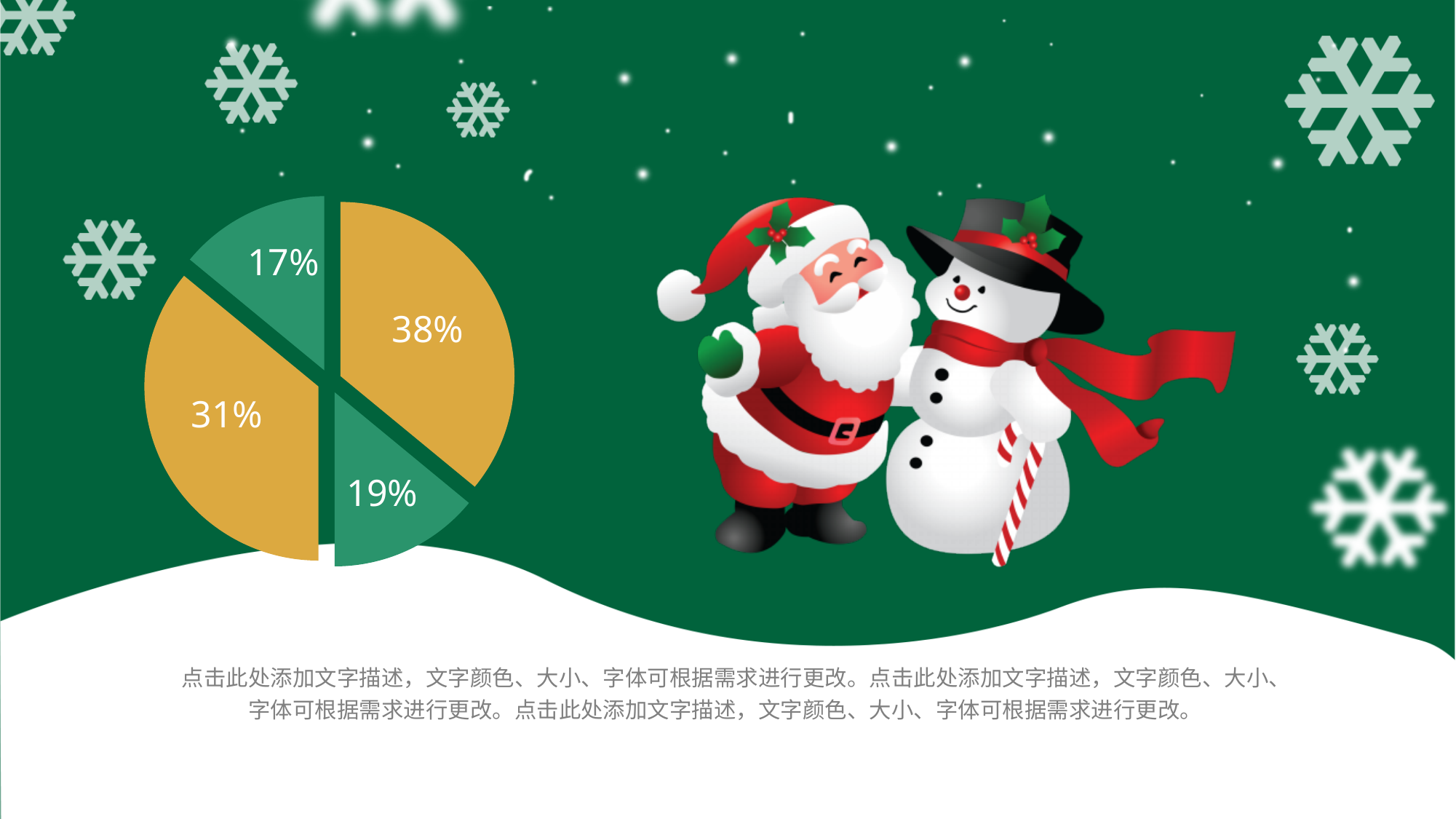
What colour is the 38% slice of the pie chart? gold What value is shown on the bottom slice of the pie chart? 19% What value is shown on the top-right slice of the pie chart? 38% What value is shown on the top-left slice of the pie chart? 17% What kind of chart is shown on the slide? pie chart What is the value of the smallest slice in the pie chart? 17% What is the difference in percentage points between the largest slice (38%) and the smallest slice (17%)? 21 Which is larger, the left slice or the bottom slice of the pie chart? the left slice (31%) How many slices does the pie chart have? 4 What value is shown on the left slice of the pie chart? 31% What is the difference in percentage points between the 31% slice and the 19% slice? 12 What is the value of the largest slice in the pie chart? 38%